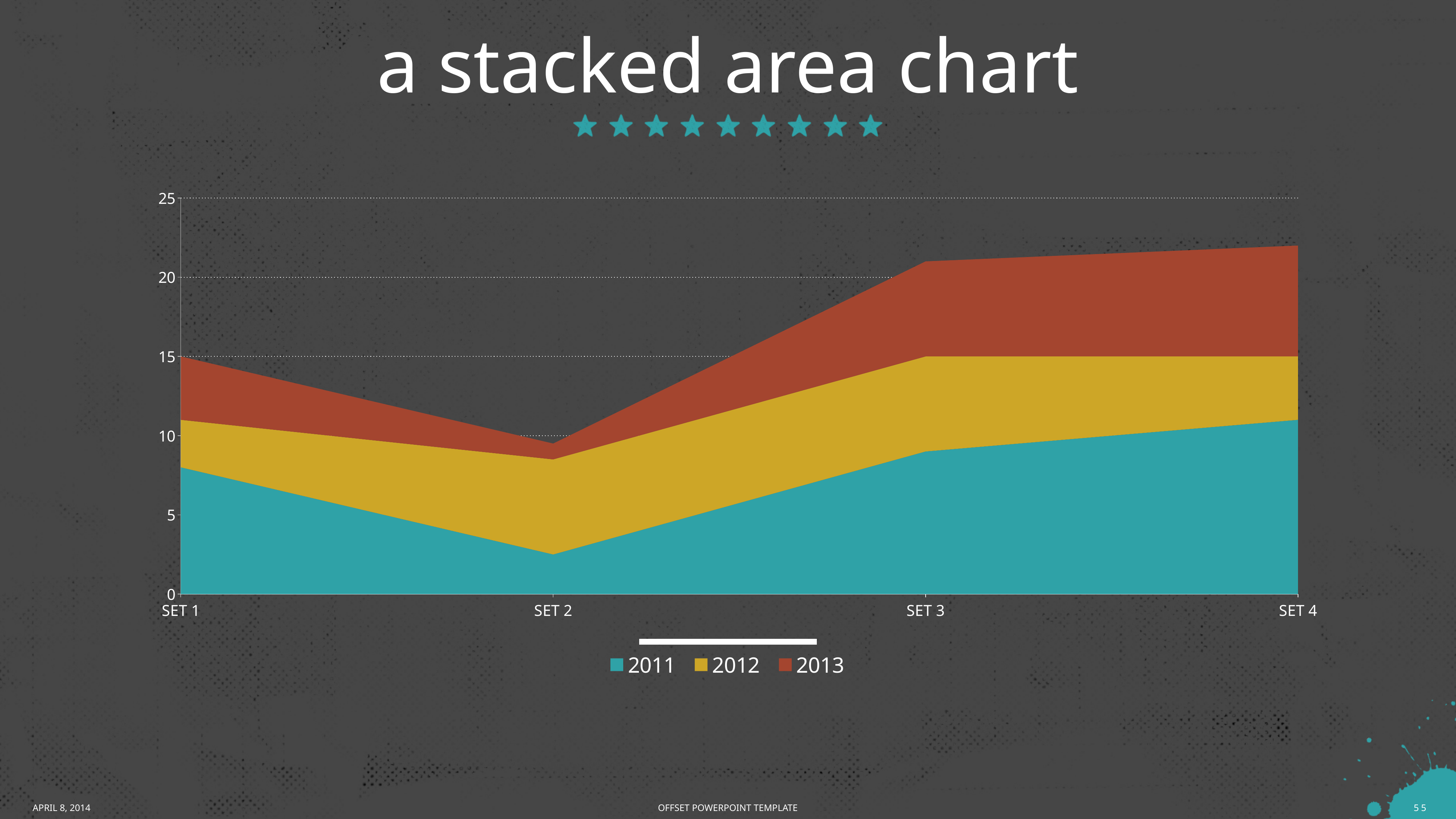
How many series does the legend list? 3 Which colour represents the 2011 series in the legend? teal Is the stacked total at SET 2 greater or less than 15? less Is the value for 2011 at SET 1 greater or less than 10? less Is the value for 2011 at SET 4 greater or less than 10? greater What is the title of the chart? a stacked area chart What kind of chart is shown on the slide? stacked area chart How many categories are shown on the x axis? 4 For the 2011 series, which category has the lowest value? SET 2 Does the 2011 series rise or fall from SET 2 to SET 4? rise